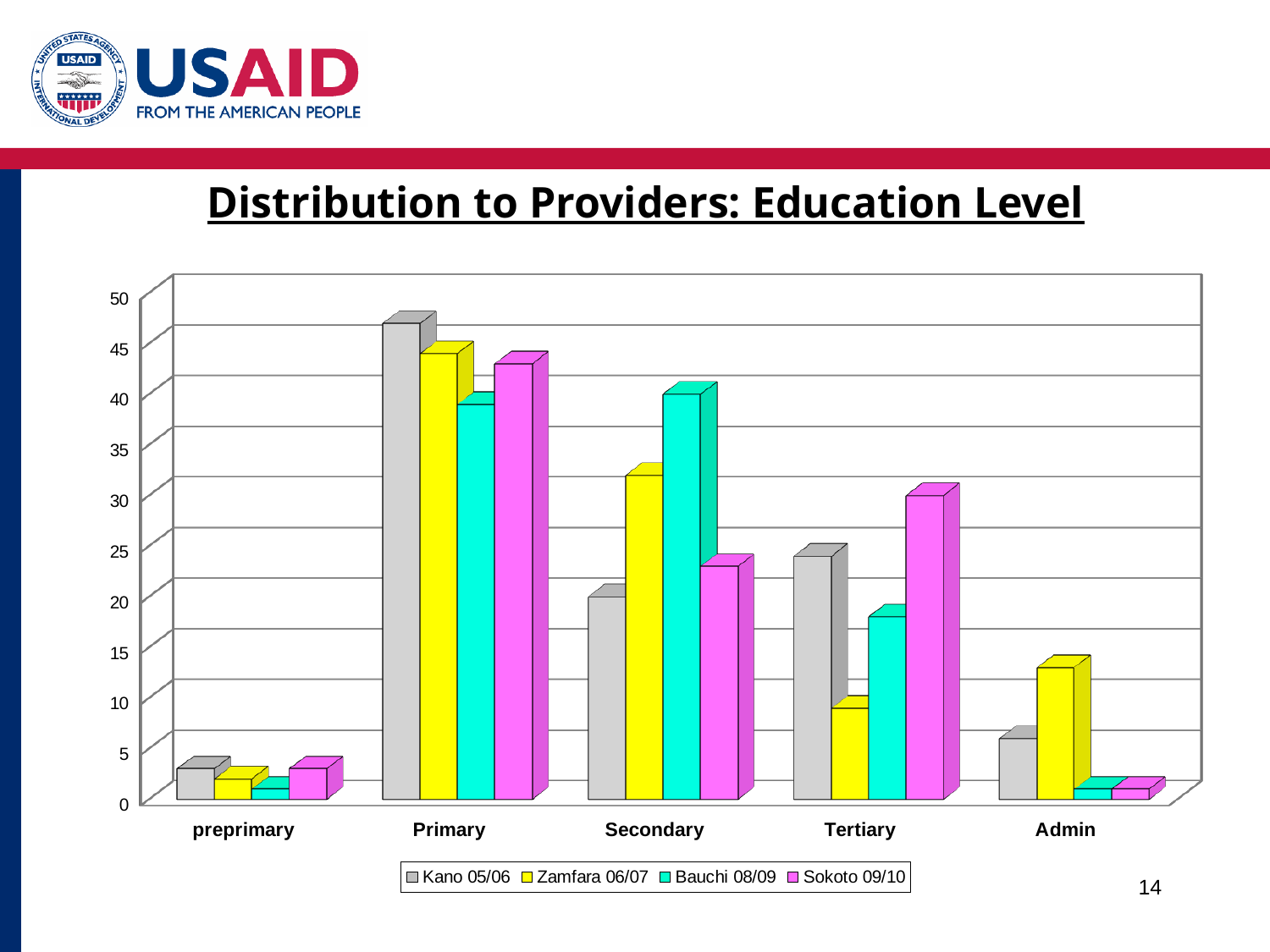
How many series does the legend list? 4 What is the title of the chart? Distribution to Providers: Education Level Is the value for Kano 05/06 in the Primary category greater or less than 45? greater What kind of chart is shown on the slide? bar chart Is the value for Sokoto 09/10 in the Tertiary category greater or less than 25? greater In the Admin category, which is larger: Zamfara 06/07 or Bauchi 08/09? Zamfara 06/07 Which series has the highest value in the Secondary category? Bauchi 08/09 How many education level categories are shown on the x axis? 5 Which series is shown in yellow in the legend? Zamfara 06/07 Which education level has the highest value for Kano 05/06? Primary In the Secondary category, which is larger: Zamfara 06/07 or Kano 05/06? Zamfara 06/07 Which series has the lowest value in the Tertiary category? Zamfara 06/07